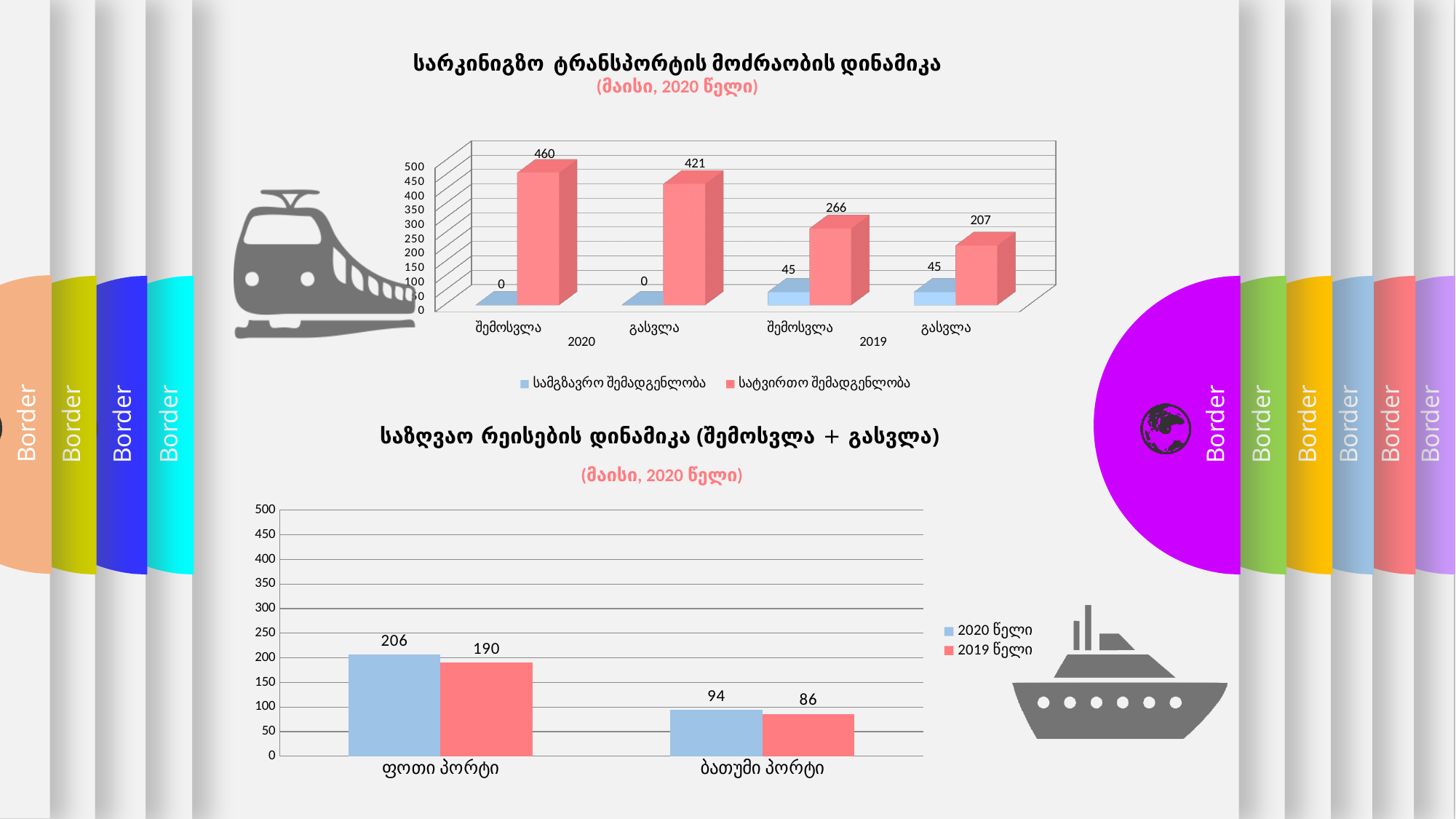
What kind of chart is the bottom chart (საზღვაო რეისების დინამიკა)? bar chart In the bottom chart (საზღვაო რეისების დინამიკა), what is the value for ფოთი პორტი in 2020 წელი? 206 In the top chart (სარკინიგზო ტრანსპორტის მოძრაობის დინამიკა), what is the value of სატვირთო შემადგენლობა for გასვლა in 2019? 207 In the top chart (სარკინიგზო ტრანსპორტის მოძრაობის დინამიკა), what is the value of სატვირთო შემადგენლობა for შემოსვლა in 2020? 460 In the bottom chart (საზღვაო რეისების დინამიკა), what is the value for ბათუმი პორტი in 2019 წელი? 86 In the top chart (სარკინიგზო ტრანსპორტის მოძრაობის დინამიკა), what is the difference between the სატვირთო შემადგენლობა values for შემოსვლა 2020 and გასვლა 2020? 39 In the top chart (სარკინიგზო ტრანსპორტის მოძრაობის დინამიკა), how many categories are shown on the x axis? 4 In the bottom chart (საზღვაო რეისების დინამიკა), what is the difference between the 2020 წელი and 2019 წელი values for ფოთი პორტი? 16 In the top chart (სარკინიგზო ტრანსპორტის მოძრაობის დინამიკა), which category has the highest სატვირთო შემადგენლობა value? შემოსვლა 2020 In the top chart (სარკინიგზო ტრანსპორტის მოძრაობის დინამიკა), how many series does the legend list? 2 In the top chart (სარკინიგზო ტრანსპორტის მოძრაობის დინამიკა), what is the value of სამგზავრო შემადგენლობა for შემოსვლა in 2019? 45 In the bottom chart (საზღვაო რეისების დინამიკა), which is larger: the 2020 წელი value for ბათუმი პორტი or the 2019 წელი value for ბათუმი პორტი? 2020 წელი